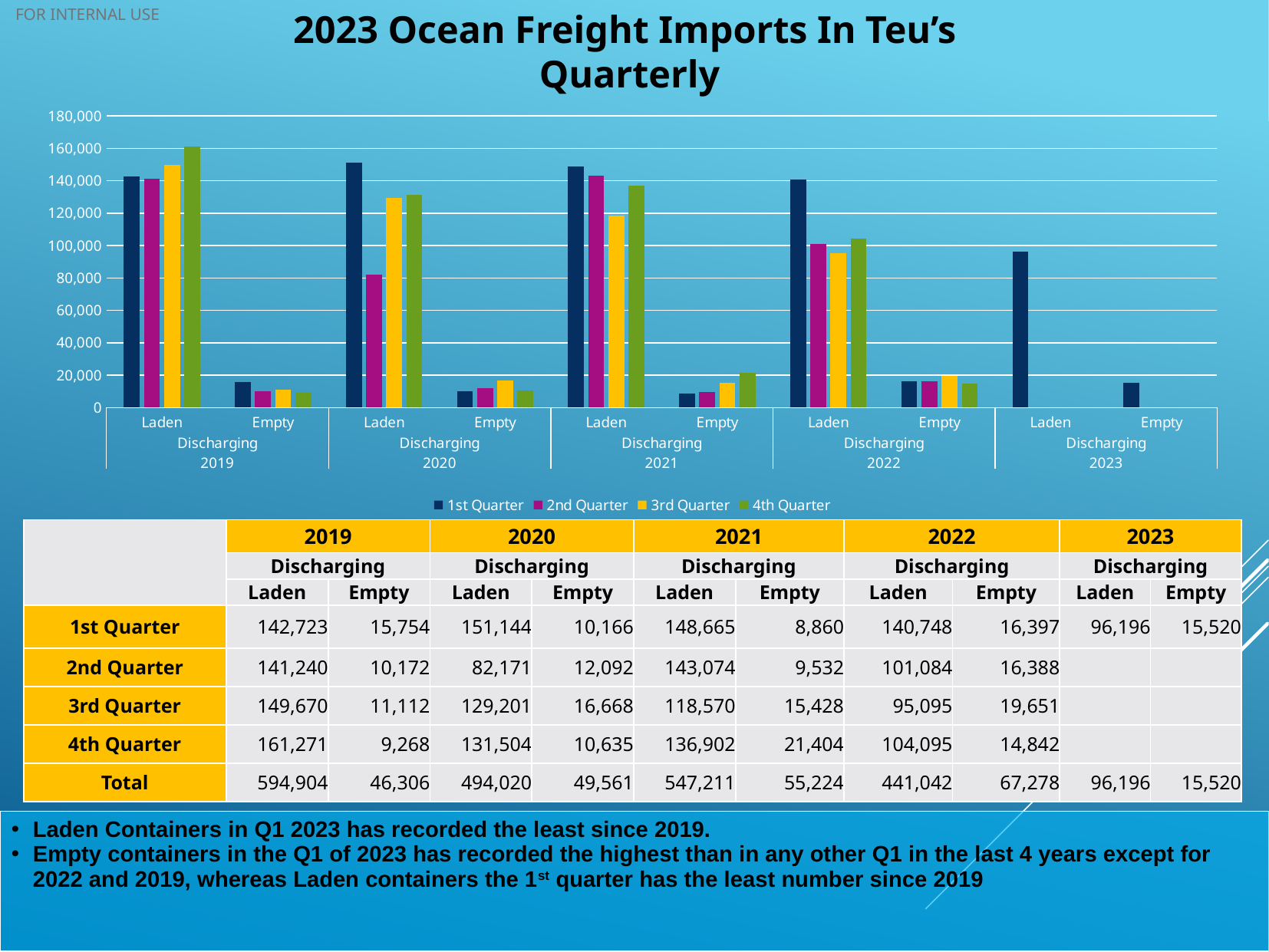
What is the Total Laden Discharging value for 2019? 594,904 How many years are shown along the x axis of the chart? 5 What is the 1st Quarter Laden Discharging value for 2019? 142,723 How many series does the chart legend list? 4 What colour represents the 4th Quarter series in the chart legend? green What is the 4th Quarter Empty Discharging value for 2021? 21,404 What kind of chart is shown on the slide? bar chart Which year has the highest 4th Quarter Laden Discharging value? 2019 Is the 1st Quarter Laden Discharging value for 2023 greater or less than 100,000? less What is the difference between the 1st Quarter Laden Discharging values for 2020 and 2021? 2,479 Which is larger, the 2nd Quarter Laden Discharging value for 2020 or for 2022? 2022 Which year has the lowest 1st Quarter Laden Discharging value? 2023